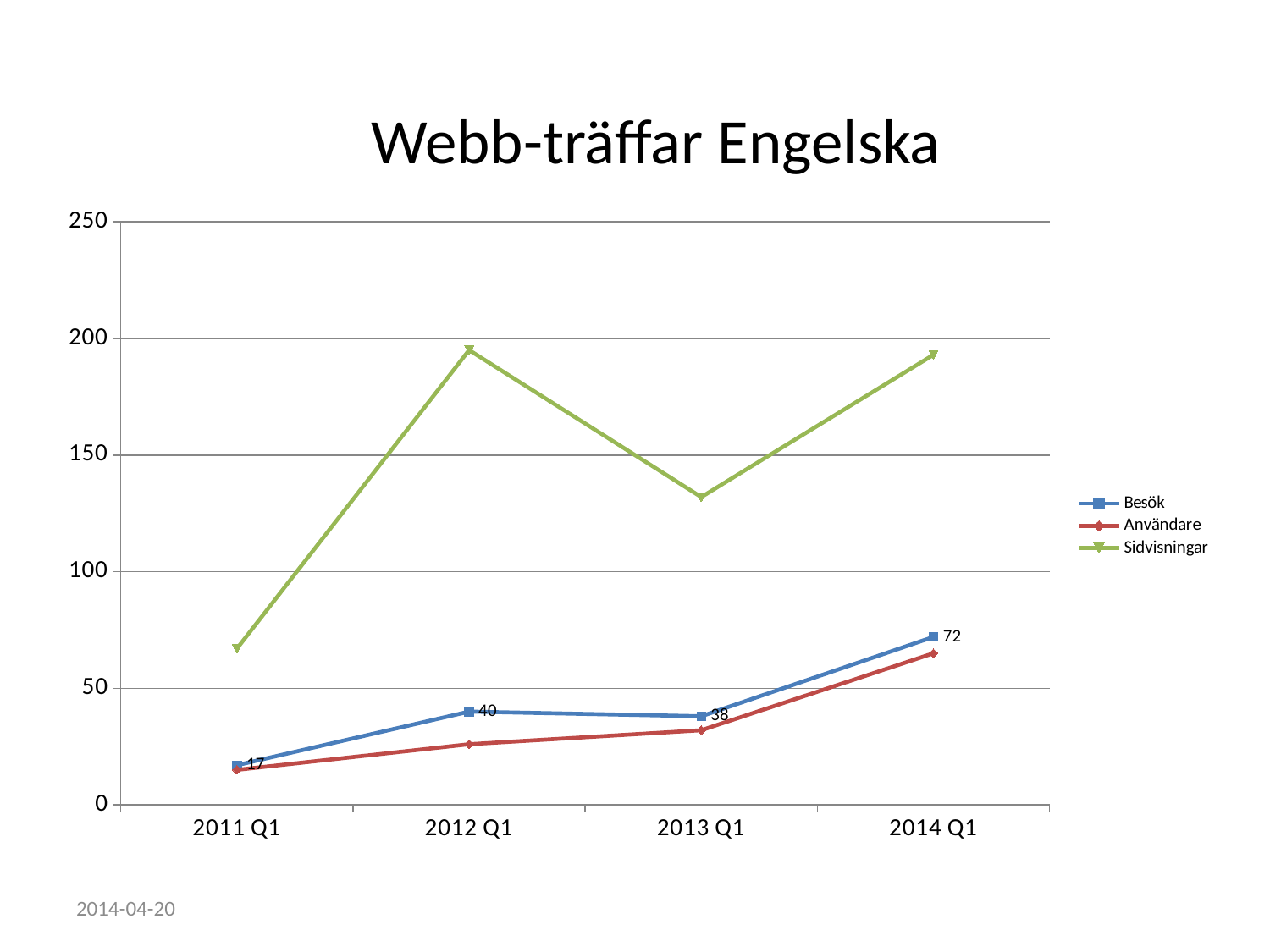
Is the value for Sidvisningar in 2011 Q1 greater or less than 100? less In which quarter is Sidvisningar lowest? 2011 Q1 How many quarters are shown on the x axis? 4 What kind of chart is shown on the slide? line chart What is the value of Besök in 2012 Q1? 40 Is the value for Sidvisningar in 2012 Q1 greater or less than 150? greater What is the value of Besök in 2011 Q1? 17 What is the value of Besök in 2014 Q1? 72 Which is larger for Besök: 2012 Q1 or 2013 Q1? 2012 Q1 How many series does the legend list? 3 By how much did Besök increase from 2011 Q1 to 2014 Q1? 55 In which quarter is Besök highest? 2014 Q1